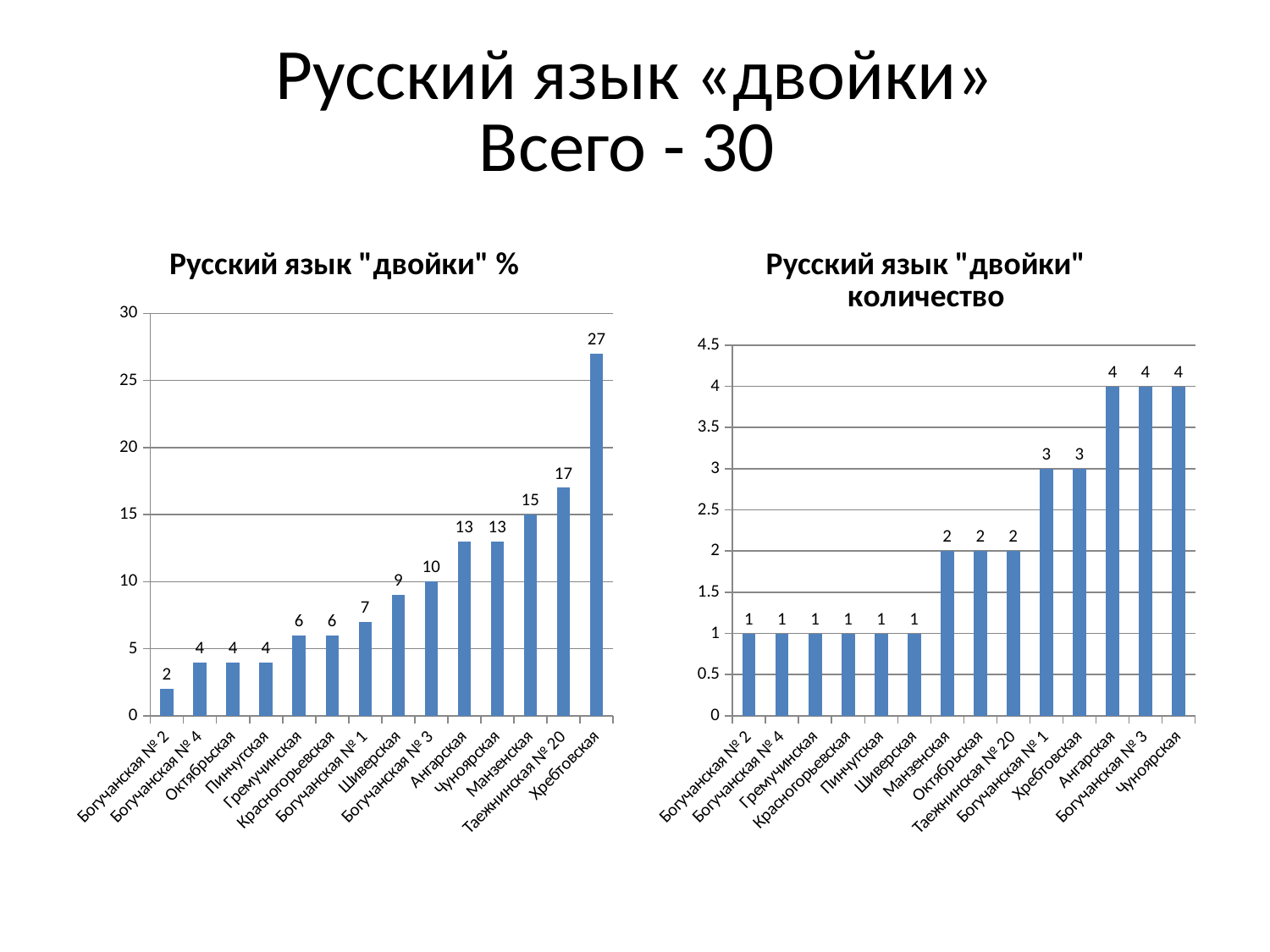
In the chart "Русский язык "двойки" %", what is the value for Хребтовская? 27 In the chart "Русский язык "двойки" количество", do the values rise or fall from left to right along the x axis? rise In the chart "Русский язык "двойки" %", which category has the highest value? Хребтовская In the chart "Русский язык "двойки" количество", what is the value for Хребтовская? 3 In the chart "Русский язык "двойки" %", which is larger, the value for Шиверская or the value for Богучанская № 1? Шиверская In the chart "Русский язык "двойки" количество", what is the value for Октябрьская? 2 In the chart "Русский язык "двойки" %", how many categories are shown on the x axis? 14 What kind of chart is "Русский язык "двойки" количество"? bar chart In the chart "Русский язык "двойки" количество", what is the difference between the values for Чуноярская and Богучанская № 2? 3 In the chart "Русский язык "двойки" %", which category has the lowest value? Богучанская № 2 In the chart "Русский язык "двойки" %", what is the difference between the values for Хребтовская and Таежнинская № 20? 10 In the chart "Русский язык "двойки" %", what is the value for Манзенская? 15